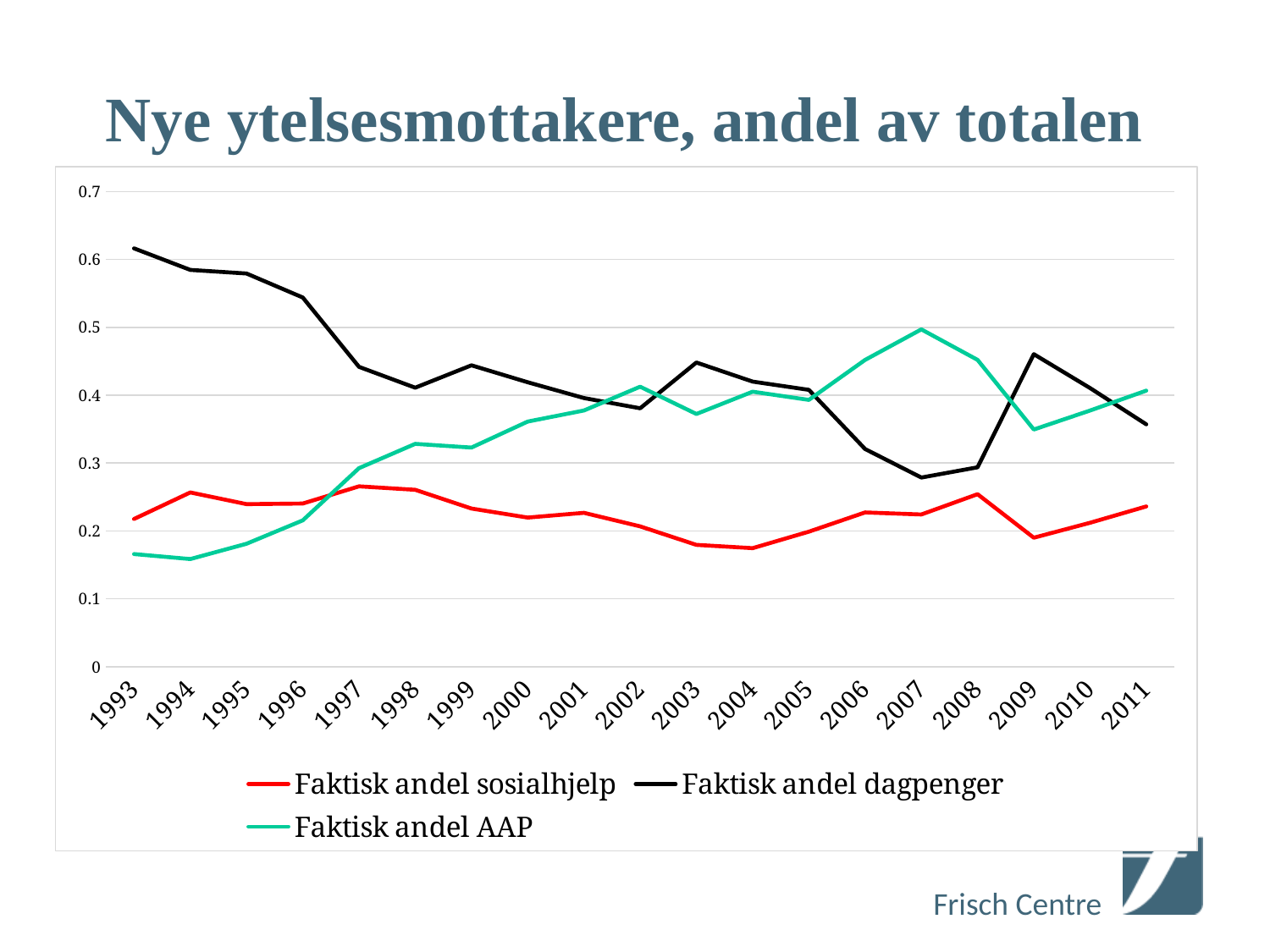
Which series has the lowest value in 2011? Faktisk andel sosialhjelp How many series does the legend list? 3 Is the value for Faktisk andel AAP in 1993 greater or less than 0.2? less In which year does Faktisk andel dagpenger reach its highest value? 1993 What is the title of the chart? Nye ytelsesmottakere, andel av totalen Does Faktisk andel dagpenger rise or fall from 1993 to 1997? fall How many years are plotted along the x axis? 19 In 2007, which series has the larger value: Faktisk andel AAP or Faktisk andel dagpenger? Faktisk andel AAP Is the value for Faktisk andel dagpenger in 1993 greater or less than 0.5? greater What kind of chart is shown on the slide? line chart Is the value for Faktisk andel dagpenger in 2007 greater or less than 0.3? less In 1993, which series has the larger value: Faktisk andel dagpenger or Faktisk andel sosialhjelp? Faktisk andel dagpenger